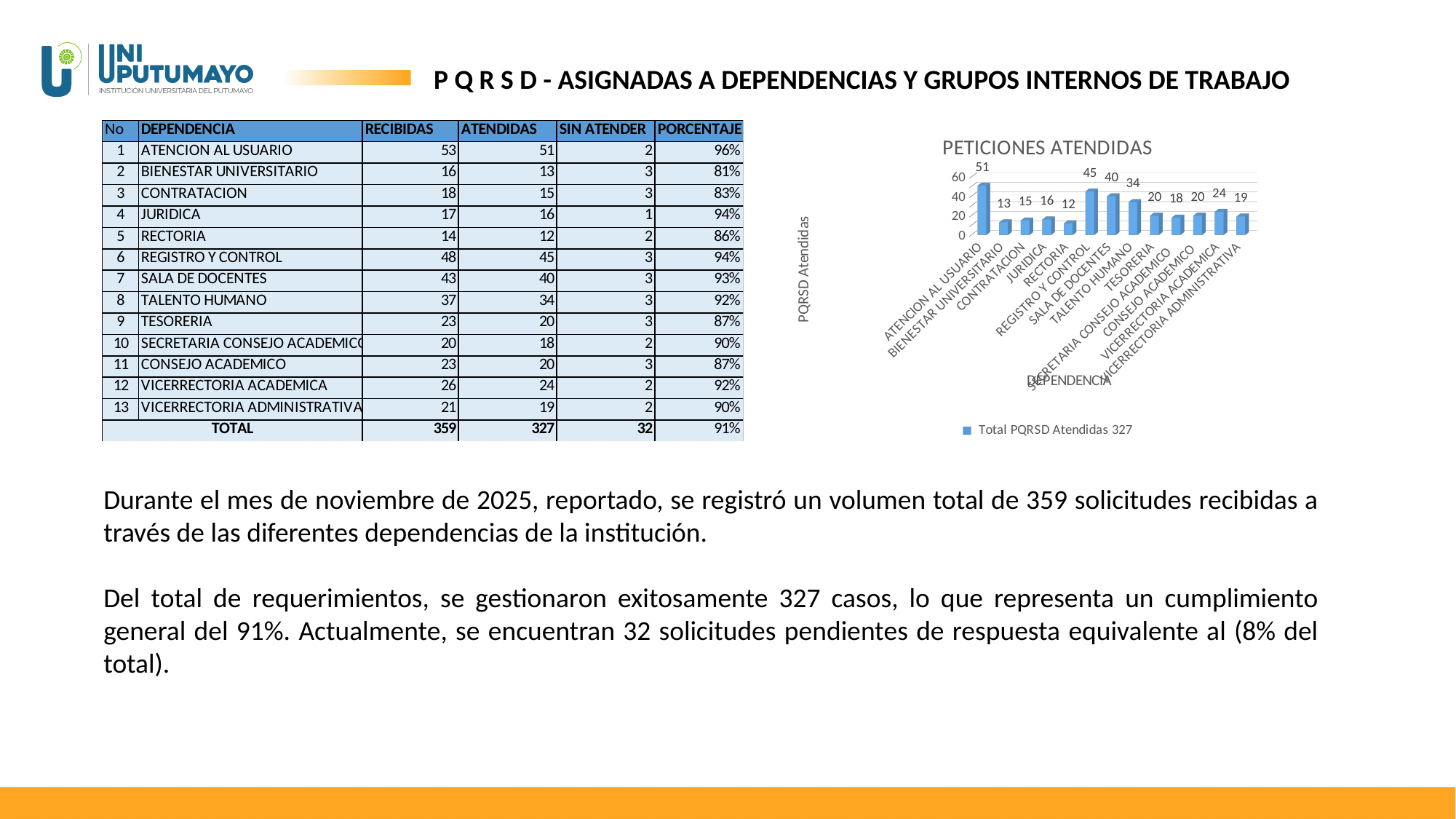
What is the value for REGISTRO Y CONTROL in the chart? 45 What is the value for ATENCION AL USUARIO in the chart? 51 Which category has the lowest value in the chart? RECTORIA What is the title of the chart? PETICIONES ATENDIDAS Which is larger in the chart, the value for VICERRECTORIA ACADEMICA or the value for VICERRECTORIA ADMINISTRATIVA? VICERRECTORIA ACADEMICA What is the value for RECTORIA in the chart? 12 What type of chart is shown on the slide? bar chart What is the difference between the values for SALA DE DOCENTES and TALENTO HUMANO? 6 How many series does the chart legend list? 1 Which category has the highest value in the chart? ATENCION AL USUARIO How many categories (dependencias) are plotted in the chart? 13 What is the legend entry shown below the chart? Total PQRSD Atendidas 327